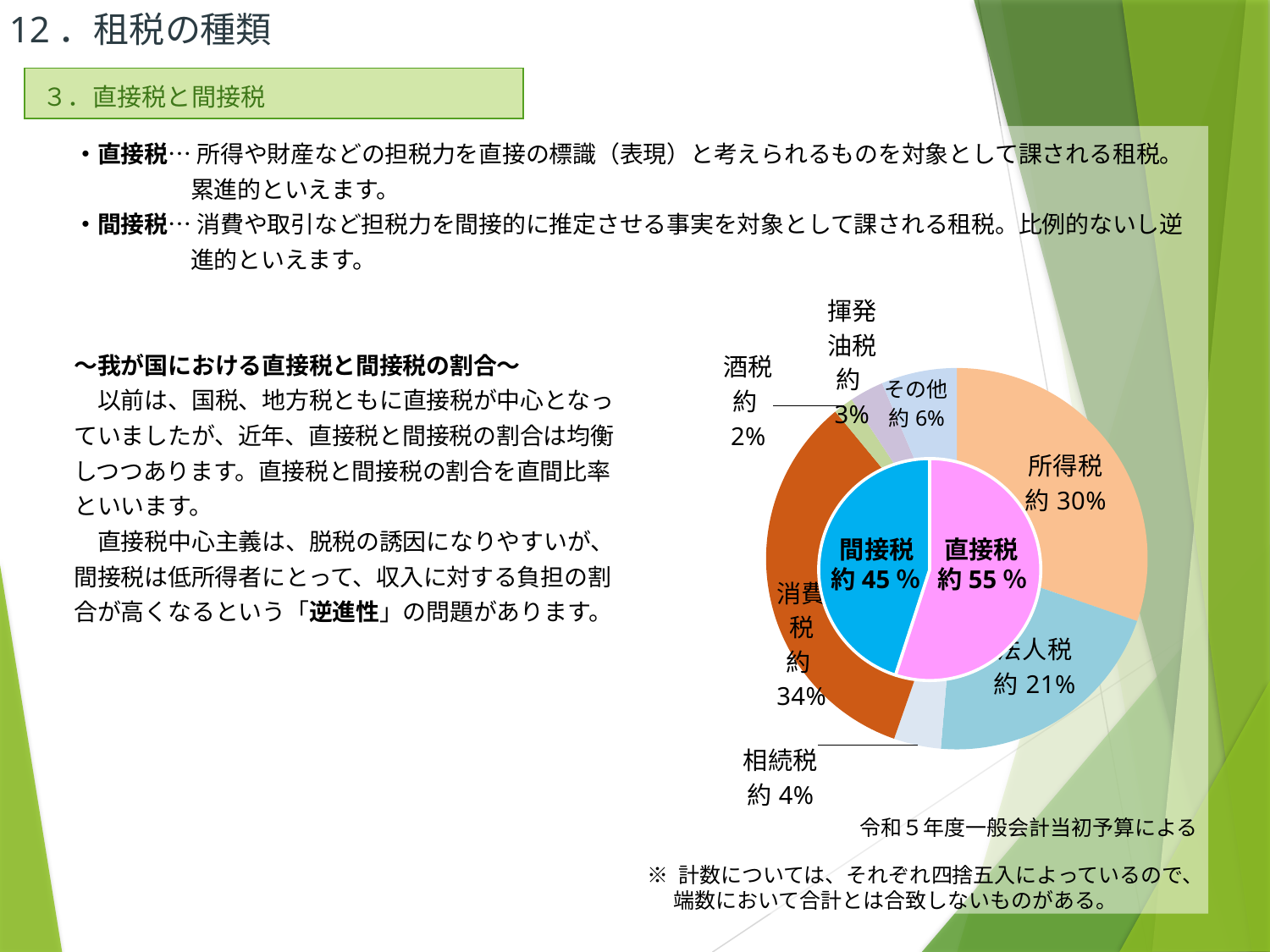
How many tax categories are labelled in the outer ring of the pie chart? 7 Which is larger in the inner ring, 直接税 or 間接税? 直接税 What kind of chart is shown on the slide? pie chart Which tax in the outer ring has the smallest share? 酒税 What is the value shown for 法人税 in the outer ring? 約 21% By how many percentage points does 所得税 exceed 法人税 in the outer ring? 9 percentage points What is the value shown for 所得税 in the outer ring? 約 30% What share does 直接税 have in the inner ring of the pie chart? 約 55％ What is the value shown for 相続税 in the outer ring? 約 4% Which tax in the outer ring has the largest share? 消費税 What share does 間接税 have in the inner ring of the pie chart? 約 45％ What is the value shown for 消費税 in the outer ring? 約 34%